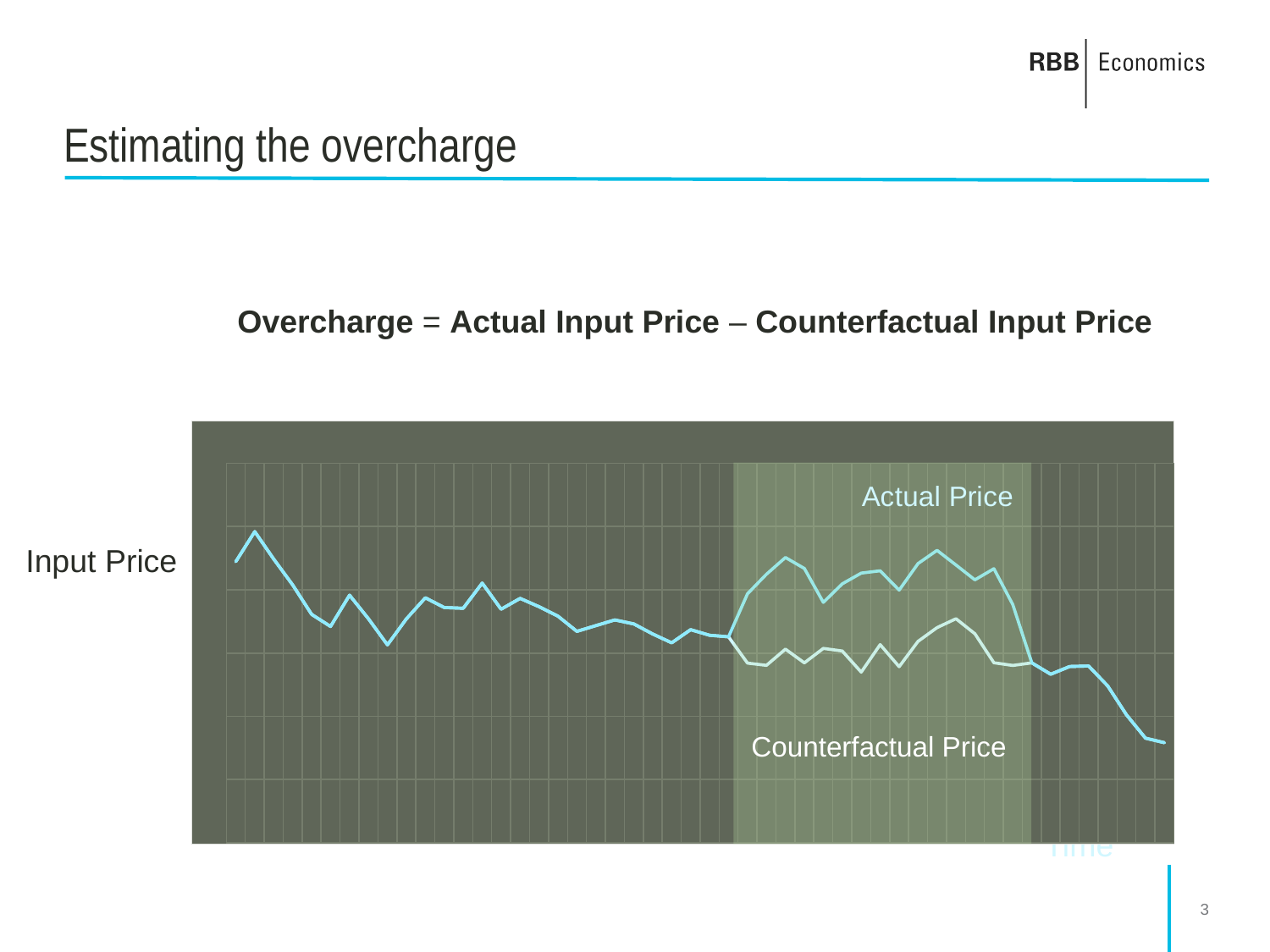
Does the price line rise or fall after the shaded region ends on the right side of the chart? fall What is the label on the vertical axis of the chart? Input Price Does the Actual Price line rise or fall at the start of the shaded region? rise Does the input price overall rise or fall from the left of the chart to the right? fall What kind of chart is shown on the slide? line chart In the shaded region of the chart, which line is higher, Actual Price or Counterfactual Price? Actual Price What are the two price series labelled in the shaded region of the chart? Actual Price and Counterfactual Price